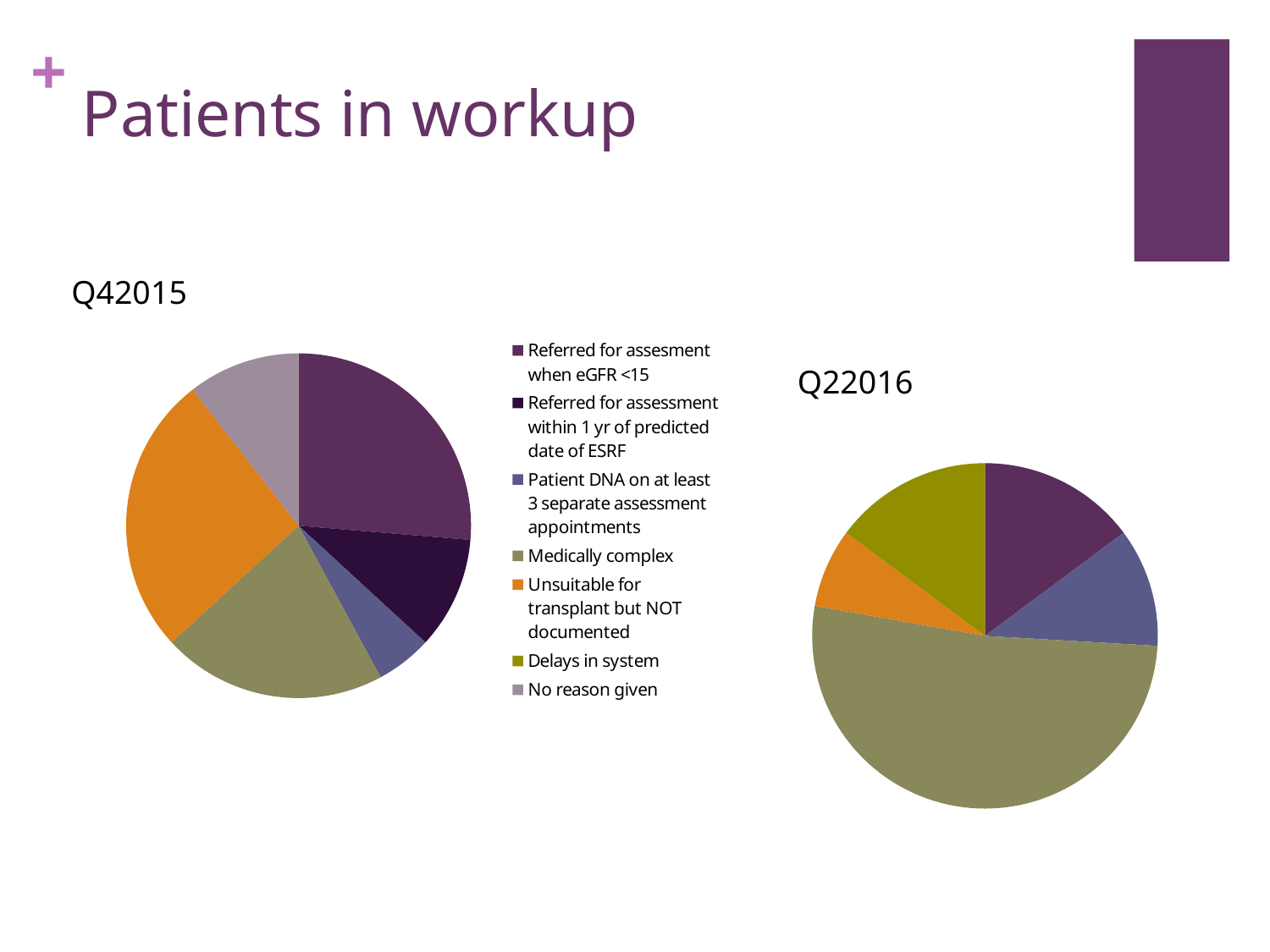
How many slices does the Q42015 pie chart have? 6 In the Q22016 pie chart, which is larger: Medically complex or Delays in system? Medically complex In the Q42015 pie chart, which category has the smallest slice? Patient DNA on at least 3 separate assessment appointments Which legend category is shown in orange? Unsuitable for transplant but NOT documented How many slices does the Q22016 pie chart have? 5 How many entries does the shared legend list? 7 What kind of chart is the Q22016 chart? pie chart What is the title of the slide containing the two pie charts? Patients in workup In the Q42015 pie chart, which is larger: Medically complex or Patient DNA on at least 3 separate assessment appointments? Medically complex In the Q22016 pie chart, which category has the largest slice? Medically complex What kind of chart is the Q42015 chart? pie chart